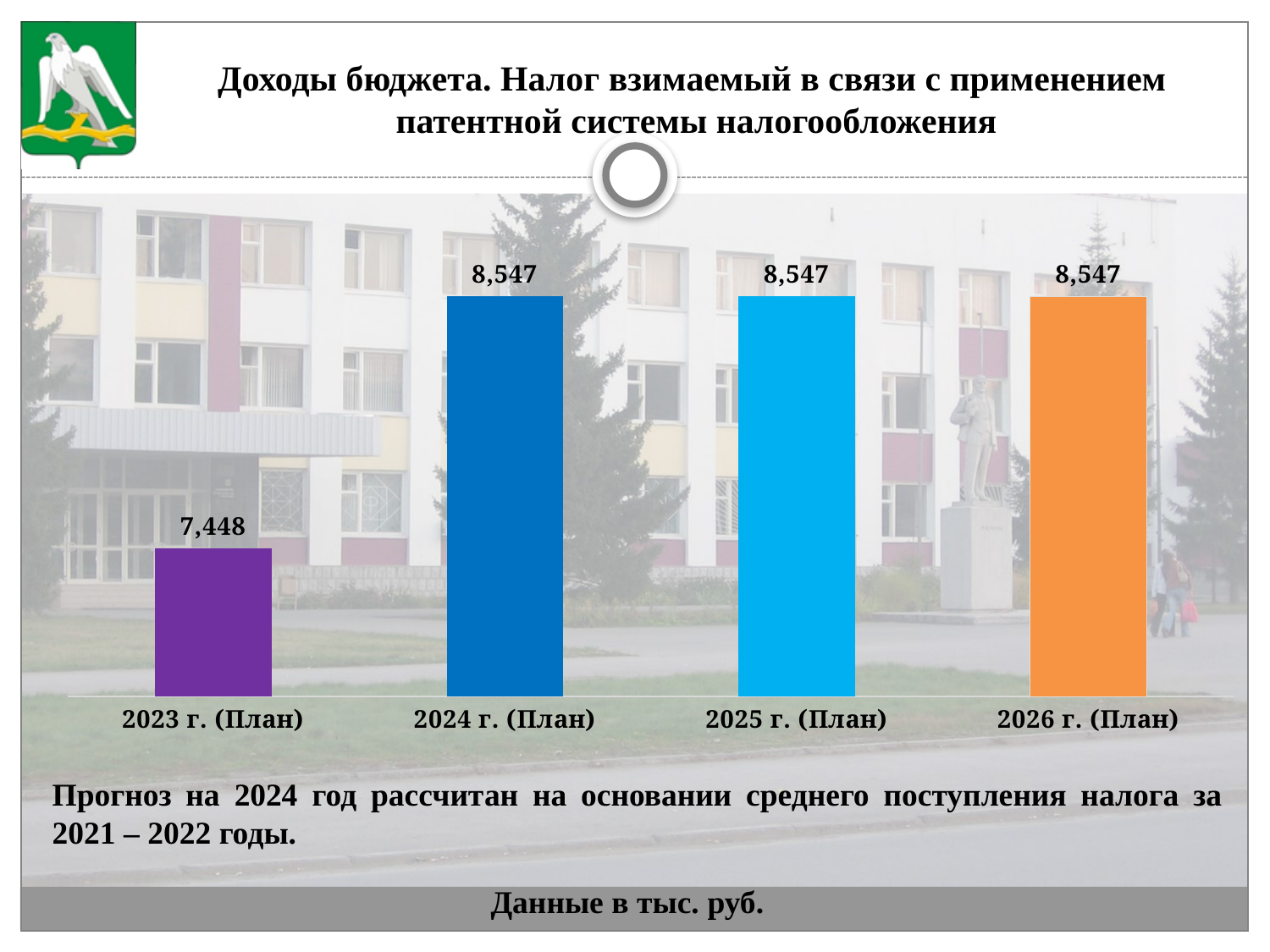
What colour is the bar for 2026 г. (План)? Orange What kind of chart is shown on the slide? Bar chart Which category has the lowest value? 2023 г. (План) What is the value for 2026 г. (План)? 8,547 How many categories share the value 8,547? 3 What is the difference between the values for 2024 г. (План) and 2023 г. (План)? 1,099 What is the value for 2023 г. (План)? 7,448 Which is larger, the value for 2023 г. (План) or the value for 2025 г. (План)? 2025 г. (План) What is the value for 2024 г. (План)? 8,547 In what units are the data on the chart given? тыс. руб. How many categories are shown on the chart? 4 Do the values rise or fall from 2023 г. (План) to 2024 г. (План)? Rise